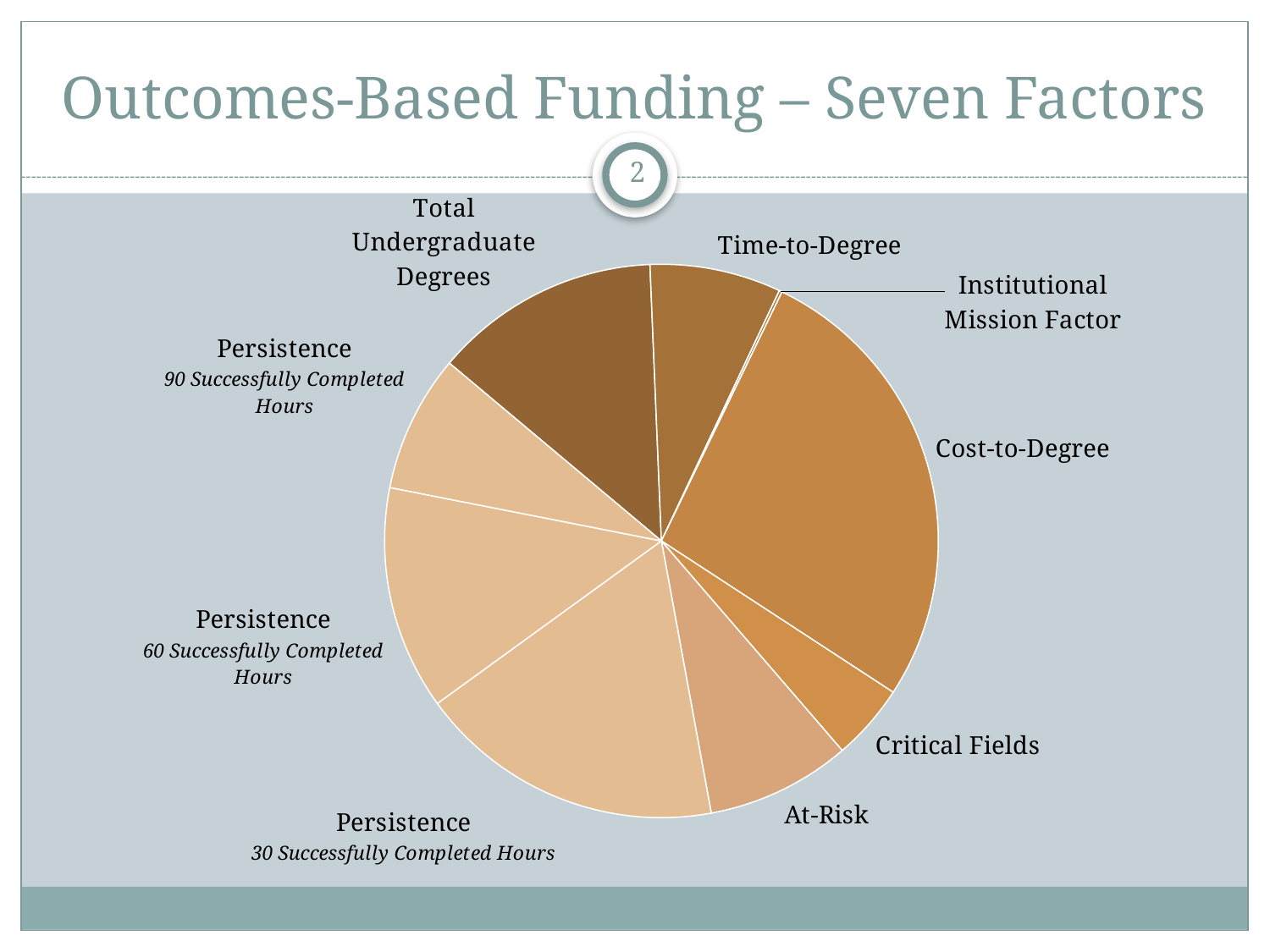
Which slice is larger, At-Risk or Critical Fields? At-Risk Which slice of the pie chart is the smallest? Institutional Mission Factor Which slice is larger, Persistence 60 Successfully Completed Hours or Critical Fields? Persistence 60 Successfully Completed Hours Which slice of the pie chart is the largest? Cost-to-Degree Which slice is larger, Total Undergraduate Degrees or Time-to-Degree? Total Undergraduate Degrees How many slices of the pie chart are labelled Persistence? 3 What is the title of the slide containing the pie chart? Outcomes-Based Funding – Seven Factors How many slices does the pie chart have? 9 What kind of chart is shown on the slide? pie chart